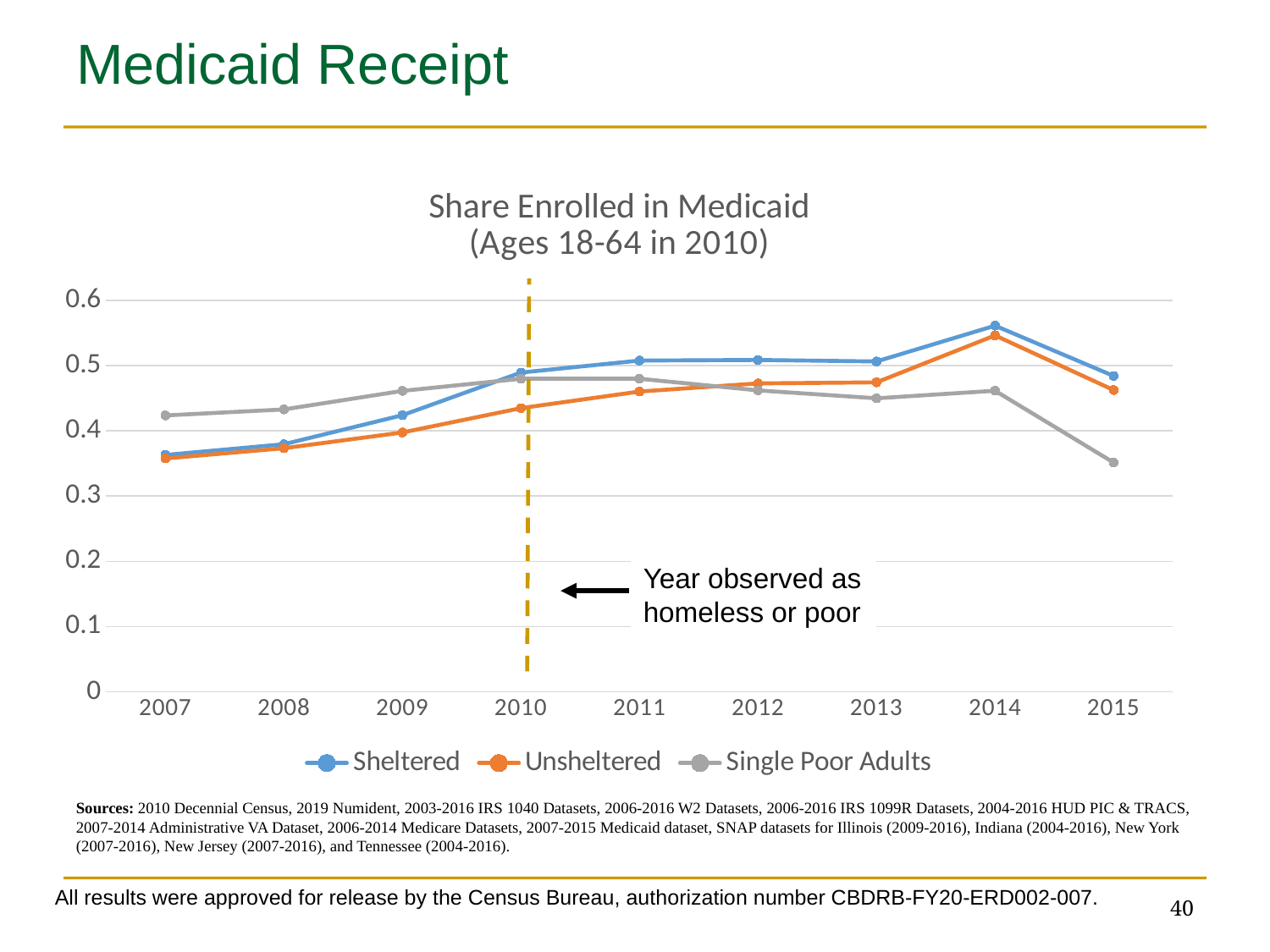
In which year does the Sheltered series reach its highest value? 2014 What kind of chart is shown on the slide? Line chart In which year does the Single Poor Adults series reach its lowest value? 2015 What is the title of the chart? Share Enrolled in Medicaid (Ages 18-64 in 2010) Which series has the lowest value in 2015? Single Poor Adults In 2007, which is larger: the value for Single Poor Adults or the value for Sheltered? Single Poor Adults Is the value for Unsheltered in 2007 greater or less than 0.4? less Is the value for Single Poor Adults in 2015 greater or less than 0.4? less Does the Sheltered series rise or fall from 2007 to 2010? Rise Is the value for Sheltered in 2014 greater or less than 0.5? greater How many series does the legend list? 3 How many years are shown on the x axis? 9